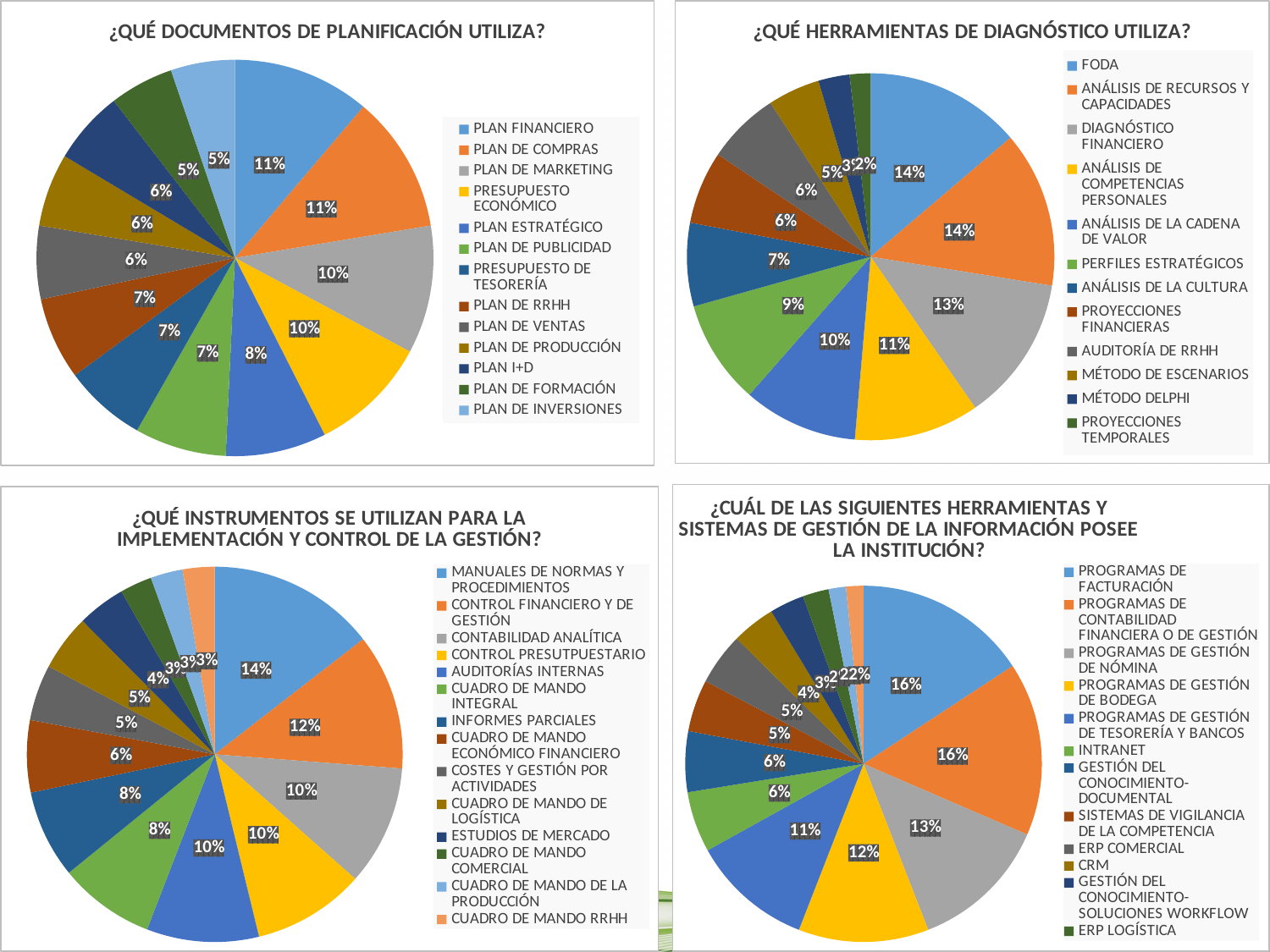
How many charts are shown on the slide? 4 In the chart titled '¿QUÉ INSTRUMENTOS SE UTILIZAN PARA LA IMPLEMENTACIÓN Y CONTROL DE LA GESTIÓN?', which is larger: CUADRO DE MANDO INTEGRAL or ESTUDIOS DE MERCADO? CUADRO DE MANDO INTEGRAL In the chart titled '¿QUÉ HERRAMIENTAS DE DIAGNÓSTICO UTILIZA?', what share does DIAGNÓSTICO FINANCIERO have? 13% In the chart titled '¿QUÉ DOCUMENTOS DE PLANIFICACIÓN UTILIZA?', how many categories does the legend list? 13 In the bottom-right chart about herramientas y sistemas de gestión de la información, what share does PROGRAMAS DE GESTIÓN DE NÓMINA have? 13% In the chart titled '¿QUÉ DOCUMENTOS DE PLANIFICACIÓN UTILIZA?', what share does PLAN ESTRATÉGICO have? 8% In the chart titled '¿QUÉ INSTRUMENTOS SE UTILIZAN PARA LA IMPLEMENTACIÓN Y CONTROL DE LA GESTIÓN?', what share does CONTROL FINANCIERO Y DE GESTIÓN have? 12% What kind of chart is used in the top-left chart titled '¿QUÉ DOCUMENTOS DE PLANIFICACIÓN UTILIZA?'? Pie chart In the bottom-right chart about herramientas y sistemas de gestión de la información, what is the difference between the shares of PROGRAMAS DE FACTURACIÓN and PROGRAMAS DE GESTIÓN DE BODEGA? 4% In the chart titled '¿QUÉ HERRAMIENTAS DE DIAGNÓSTICO UTILIZA?', what is the difference between the shares of FODA and PERFILES ESTRATÉGICOS? 5% In the chart titled '¿QUÉ HERRAMIENTAS DE DIAGNÓSTICO UTILIZA?', which category has the smallest share? PROYECCIONES TEMPORALES In the chart titled '¿QUÉ INSTRUMENTOS SE UTILIZAN PARA LA IMPLEMENTACIÓN Y CONTROL DE LA GESTIÓN?', which category has the largest share? MANUALES DE NORMAS Y PROCEDIMIENTOS